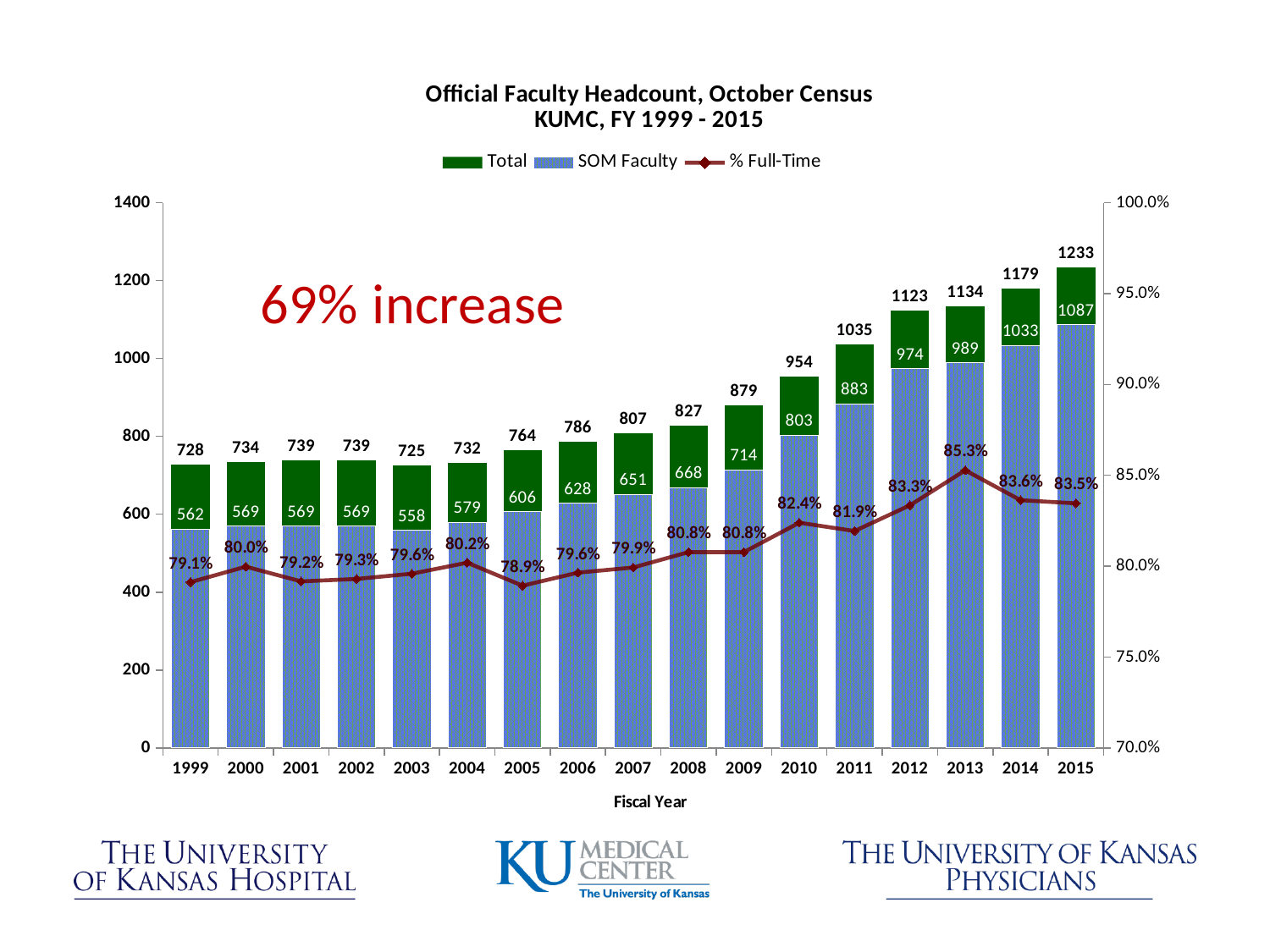
Which fiscal year has the highest Total faculty headcount? 2015 Which is larger, the Total headcount in 2007 or in 2008? 2008 What is the % Full-Time value for fiscal year 2013? 85.3% What is the Total faculty headcount for fiscal year 2010? 954 Which fiscal year has the lowest % Full-Time value? 2005 What is the SOM Faculty value for fiscal year 2005? 606 By how much did the SOM Faculty count increase from 2014 to 2015? 54 Which fiscal year has the lowest Total faculty headcount? 2003 How many fiscal years are shown on the x axis? 17 How many series does the legend list? 3 What is the title of the chart? Official Faculty Headcount, October Census KUMC, FY 1999 - 2015 What is the difference between the Total headcount in 2015 and in 1999? 505